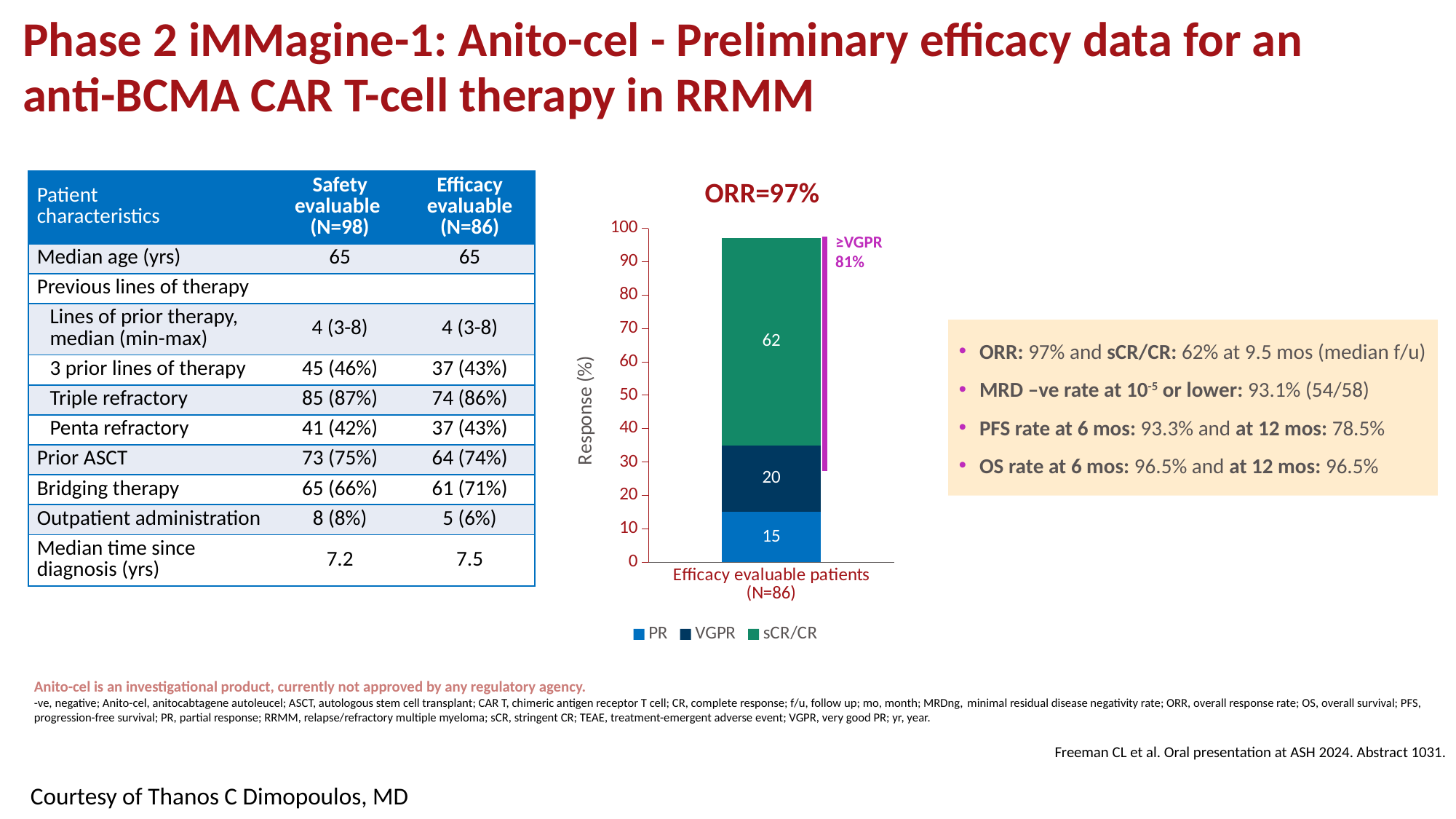
What is the total of the stacked bar for efficacy evaluable patients (N=86)? 97 What is the value of the PR segment in the bar chart? 15 What ORR value is annotated above the bar chart? ORR=97% How many categories are plotted on the x axis of the chart? 1 What kind of chart is shown on the slide? Stacked bar chart What is the difference between the sCR/CR and VGPR segment values? 42 What is the value of the sCR/CR segment in the bar chart? 62 Which is larger, the VGPR segment or the PR segment? VGPR Which series has the largest segment in the stacked bar? sCR/CR How many series does the chart legend list? 3 Which series has the smallest segment in the stacked bar? PR What is the value of the VGPR segment in the bar chart? 20